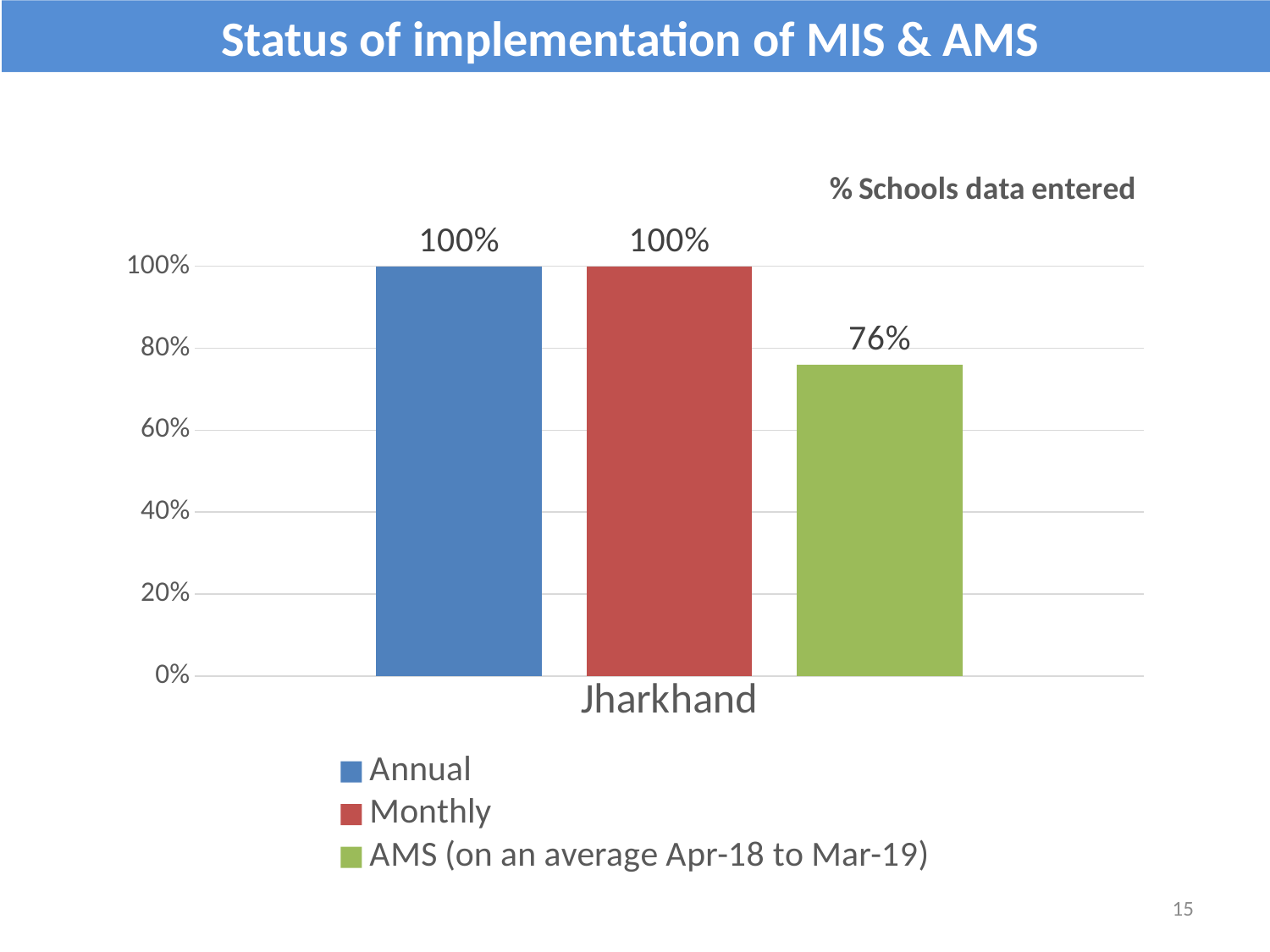
How many series does the legend list? 3 Which is larger for Jharkhand, the Monthly value or the AMS value? Monthly What is the title of the chart? % Schools data entered How many categories are shown on the x axis? 1 What is the difference between the Annual value and the AMS value for Jharkhand? 24% What colour is the bar for Monthly? red What is the value for Annual for Jharkhand? 100% What kind of chart is shown on the slide? bar chart What is the value for Monthly for Jharkhand? 100% What is the value for AMS (on an average Apr-18 to Mar-19) for Jharkhand? 76% Which series has the lowest value for Jharkhand? AMS (on an average Apr-18 to Mar-19) Is the AMS value for Jharkhand greater or less than 80%? less